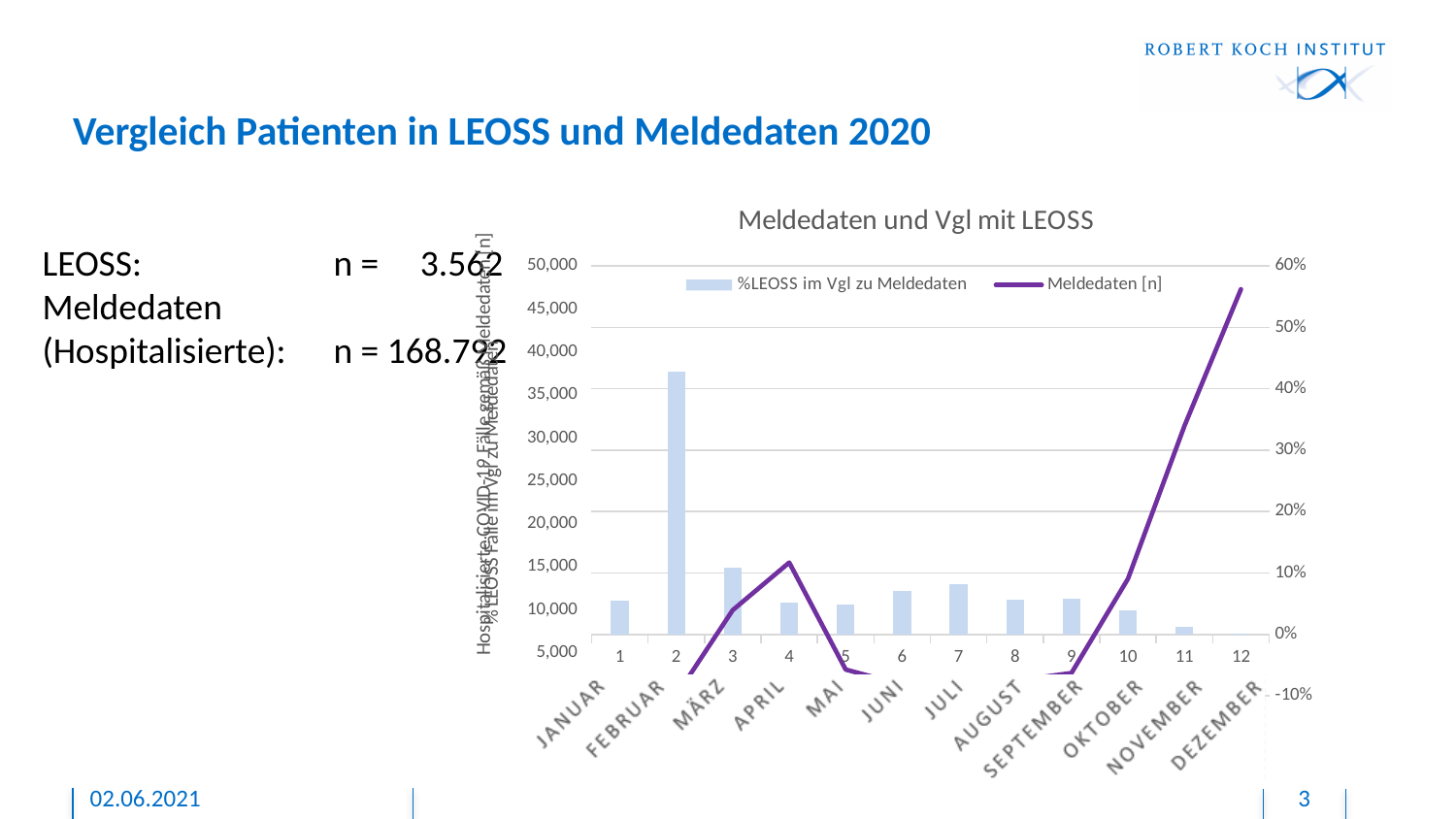
How many months (categories) are shown on the x axis of the chart? 12 In which month is the bar for %LEOSS im Vgl zu Meldedaten the shortest? Dezember Which month has the taller bar, Juli or Oktober? Juli Which month has the taller bar, Februar or März? Februar What kind of chart is shown on the slide? Combined bar and line chart Which series is drawn as a line in the chart? Meldedaten [n] How many series does the chart legend list? 2 Does the Meldedaten [n] line rise or fall from September to Dezember? Rises What is the title of the chart? Meldedaten und Vgl mit LEOSS In which month does the Meldedaten [n] line reach its highest point? Dezember In which month is the bar for %LEOSS im Vgl zu Meldedaten the tallest? Februar